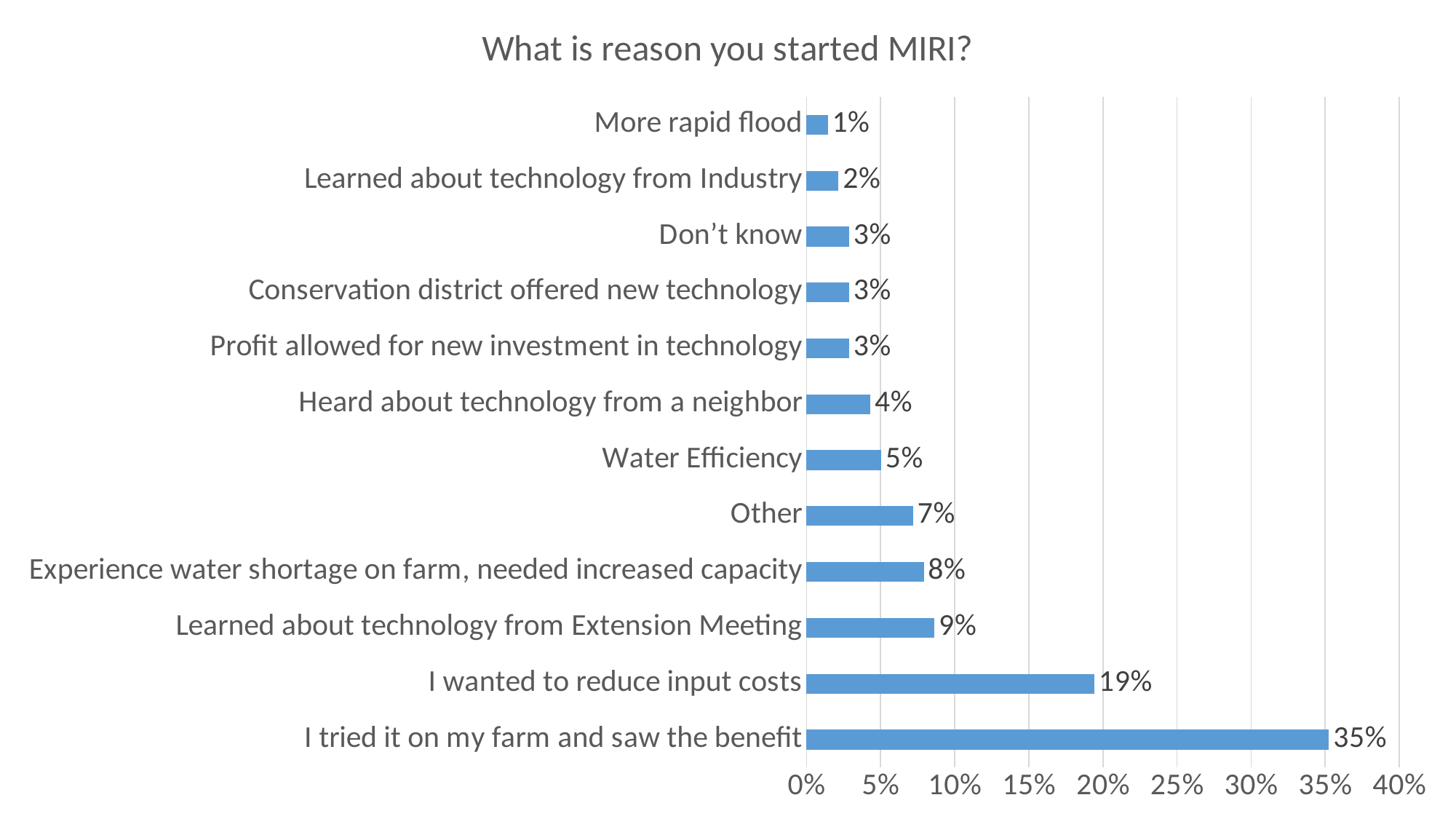
Which category has the lowest value? More rapid flood What kind of chart is shown on the slide? Bar chart What is the value for "I wanted to reduce input costs"? 19% What is the value for "Water Efficiency"? 5% What is the title of the chart? What is reason you started MIRI? Which is larger, "Other" or "Heard about technology from a neighbor"? Other What is the value for "I tried it on my farm and saw the benefit"? 35% What is the value for "Learned about technology from Extension Meeting"? 9% Which category has the highest value? I tried it on my farm and saw the benefit What is the difference between "Experience water shortage on farm, needed increased capacity" and "Learned about technology from Industry"? 6% What is the difference between "I tried it on my farm and saw the benefit" and "I wanted to reduce input costs"? 16% How many categories are shown in the chart? 12